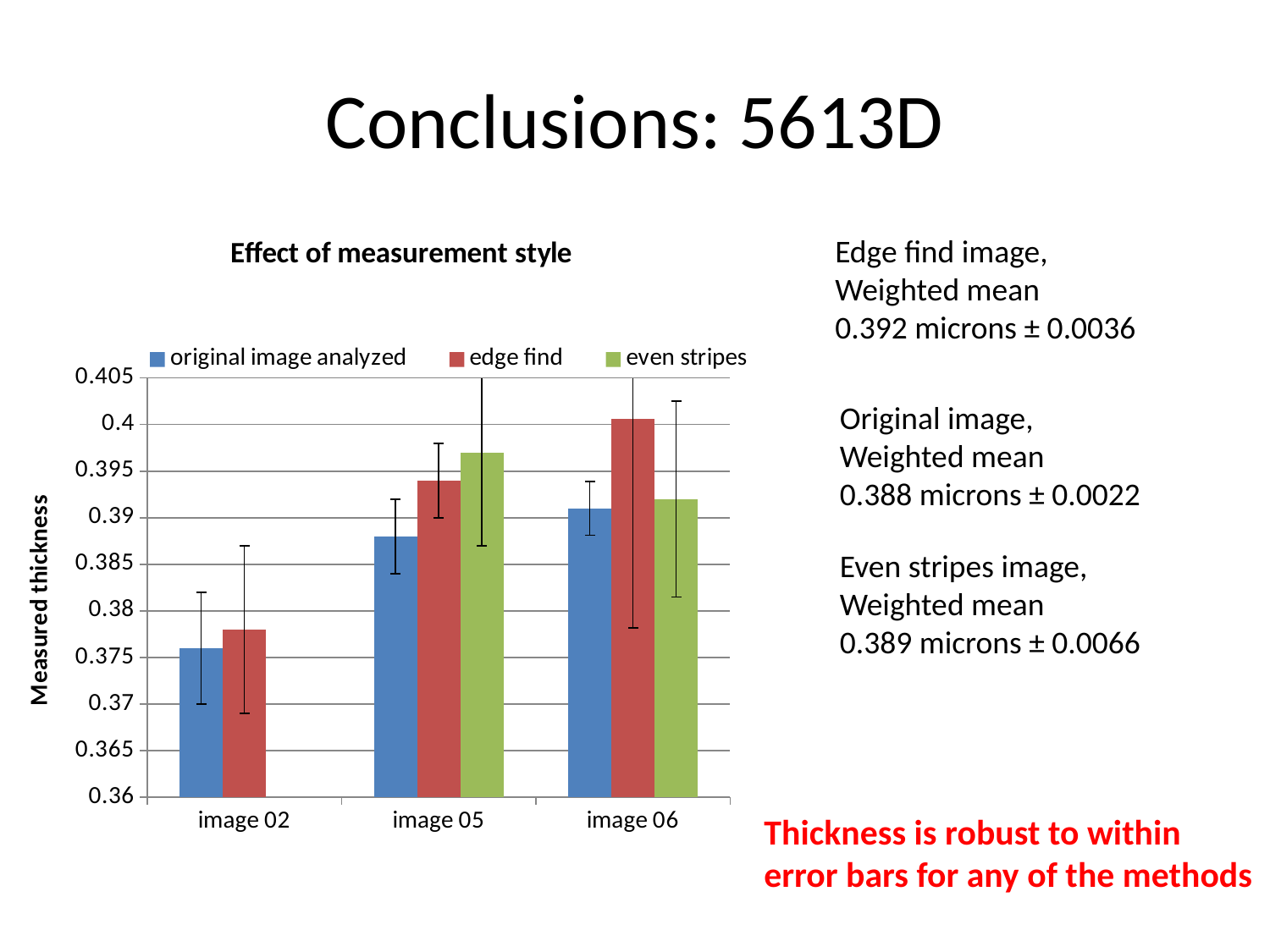
What is the label of the vertical axis of the chart? Measured thickness How many series does the chart legend list? 3 Which bar is the shortest in the chart? original image analyzed for image 02 Do the original image analyzed values rise or fall from image 02 to image 06? rise Is the edge find value for image 06 greater or less than 0.395? greater Is the original image analyzed value for image 02 greater or less than 0.38? less How many image categories are shown on the x axis of the chart? 3 Which bar is the tallest in the chart? edge find for image 06 What kind of chart is shown on the slide? bar chart What is the title of the chart? Effect of measurement style For image 05, which series has the highest measured thickness? even stripes For image 06, which is larger: the edge find value or the even stripes value? edge find